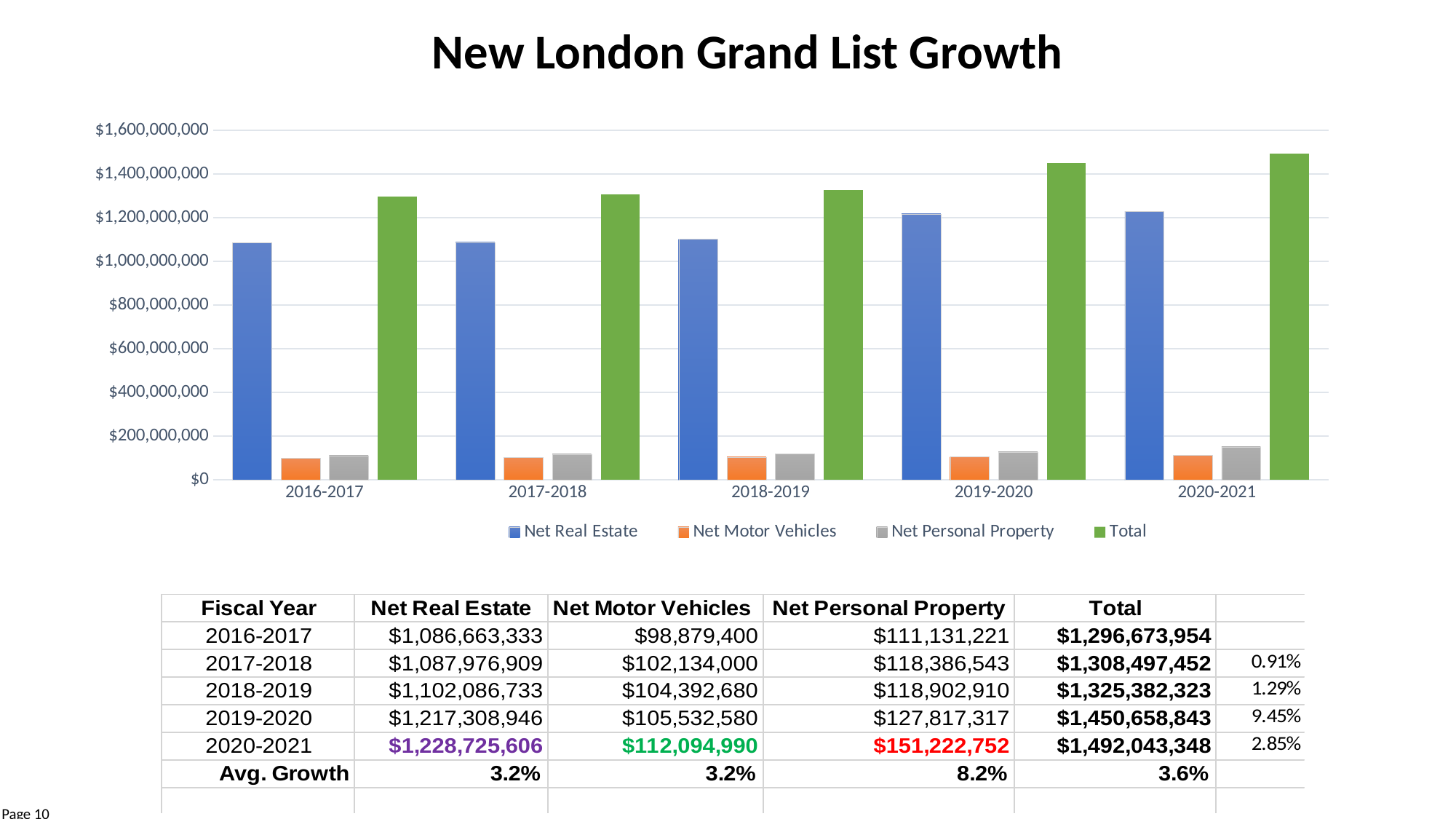
What is the Net Personal Property value for fiscal year 2019-2020? $127,817,317 What is the title of the chart? New London Grand List Growth What is the Net Real Estate value for fiscal year 2016-2017? $1,086,663,333 What is the difference between the Total for 2020-2021 and the Total for 2019-2020? $41,384,505 What kind of chart is shown on the slide? bar chart Is the Net Real Estate value for 2019-2020 greater or less than $1,200,000,000? greater Does the Total rise or fall across the fiscal years from 2016-2017 to 2020-2021? rise Which fiscal year has the highest Total? 2020-2021 How many fiscal years are shown on the x axis of the chart? 5 Which fiscal year has the lowest Net Motor Vehicles value? 2016-2017 What is the Total value for fiscal year 2020-2021? $1,492,043,348 How many series does the chart legend list? 4